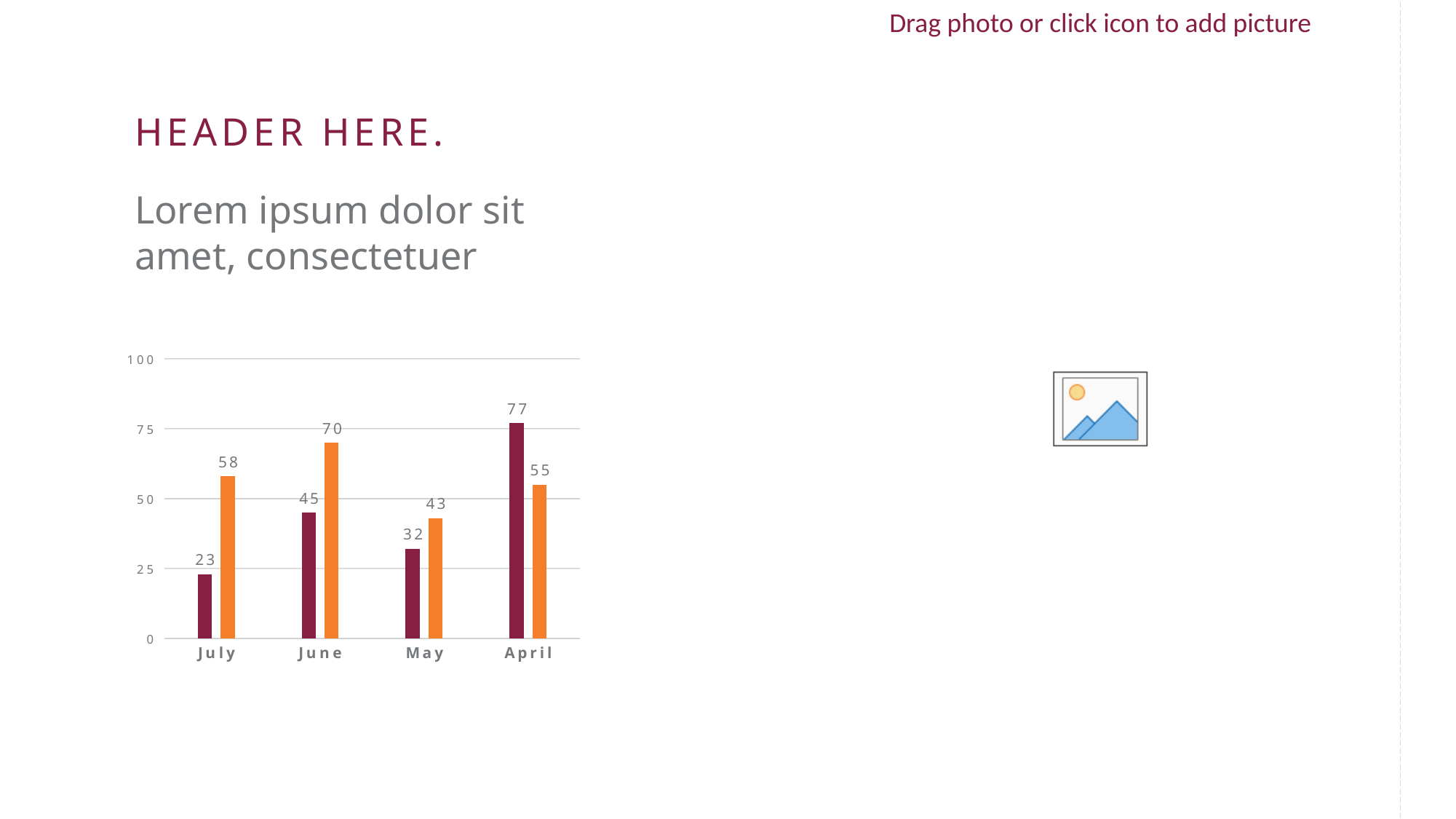
Which category has the highest dark red bar? April Which is larger for April, the dark red bar or the orange bar? the dark red bar How many categories are shown on the x axis of the chart? 4 What is the difference between the orange bar and the dark red bar for July? 35 What is the value of the dark red bar for April? 77 What is the value of the dark red bar for July? 23 What type of chart is shown on the slide? bar chart What are the two bar colours used in the chart? dark red and orange What is the value of the orange bar for May? 43 Which category has the lowest orange bar? May What is the value of the orange bar for June? 70 Is the value of the dark red bar for June greater or less than 50? less